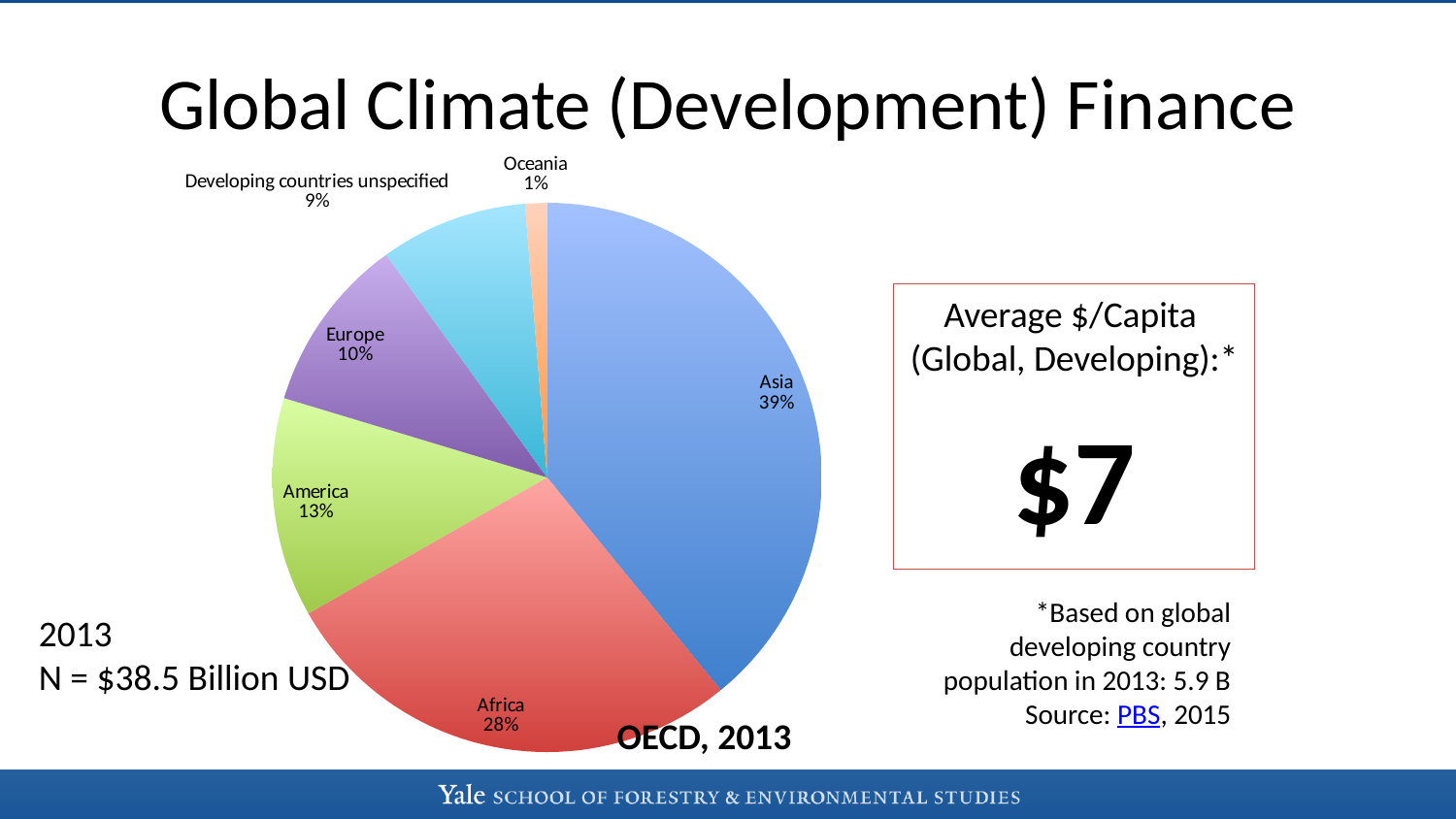
Which region has the largest slice of the pie? Asia What share of the pie does Asia account for? 39% What percentage is shown for Europe? 10% What percentage is shown for Africa? 28% Which is larger, the share for America or the share for Europe? America Which region has the smallest slice of the pie? Oceania What total amount (N) does the pie chart represent for 2013? $38.5 Billion USD What is the combined share of Asia and Africa? 67% What is the difference in percentage points between Asia and Africa? 11 How many slices does the pie chart have? 6 What type of chart is shown on the slide? pie chart What percentage is shown for Developing countries unspecified? 9%